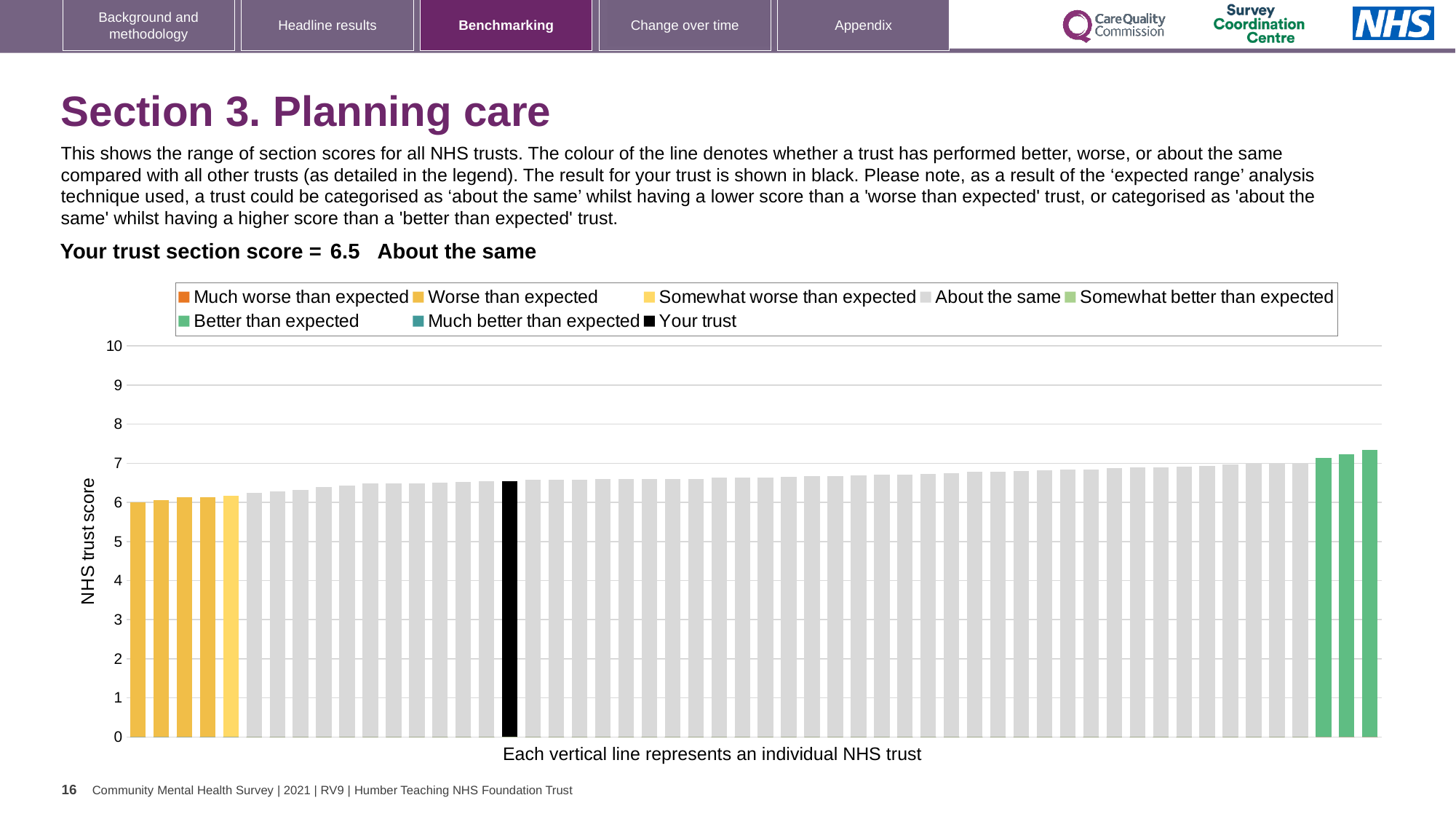
Which performance category is your trust placed in for this section? About the same Is the value of the leftmost bar greater or less than 7? less What is the section score for your trust shown on the slide? 6.5 What kind of chart is shown on the slide? bar chart How many entries does the chart legend list? 8 What is the title of the vertical axis? NHS trust score How many bars are coloured green (better than expected) in the chart? 3 Is the value of the black bar (your trust) greater or less than 7? less What colour is used for the bar representing your trust? black Do the bar values rise or fall from left to right across the chart? rise Is the value of the tallest bar on the right of the chart greater or less than 7? greater Which is higher: the black bar for your trust or the leftmost bar? the black bar for your trust